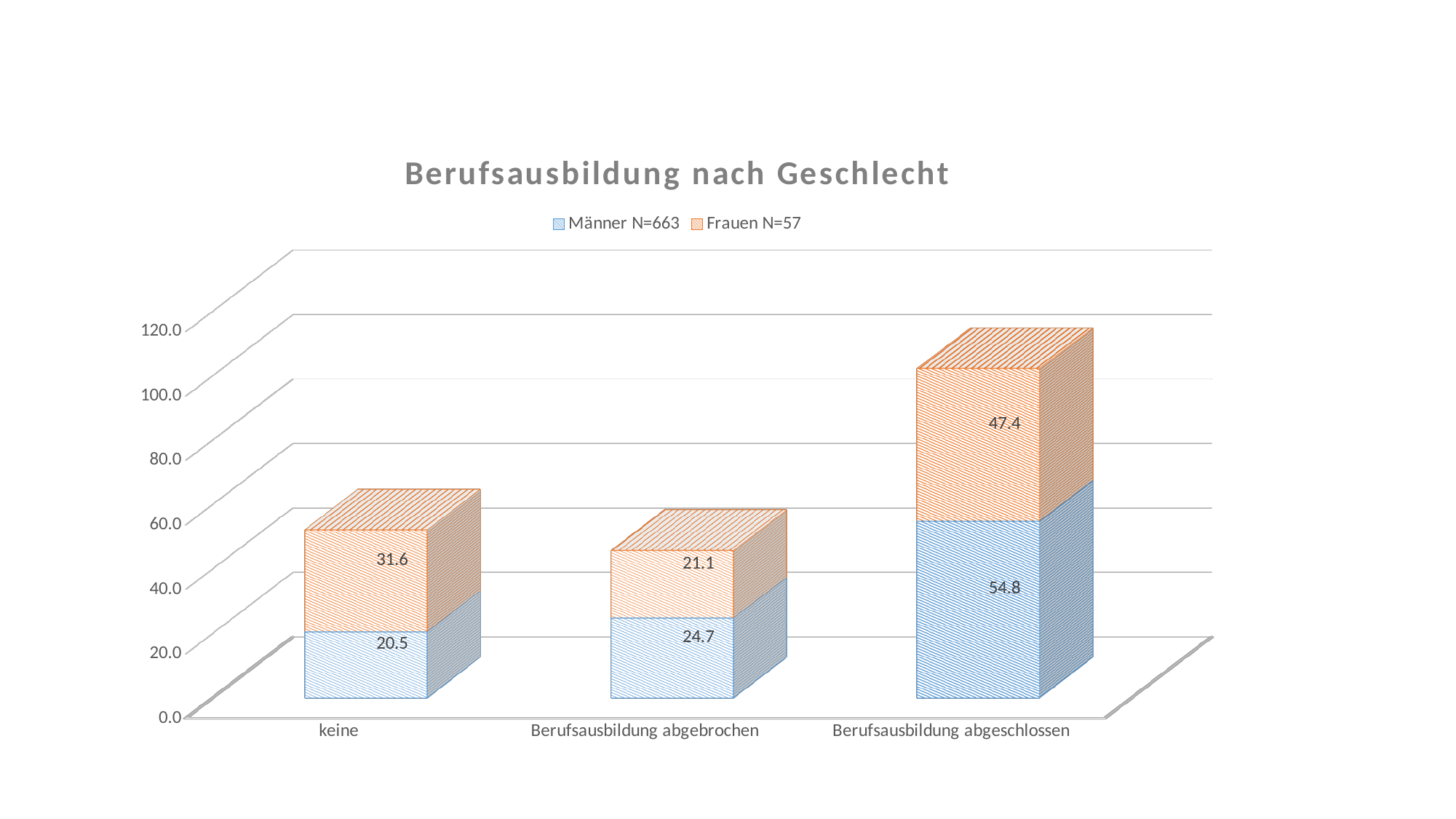
What is the value for Frauen N=57 in the 'Berufsausbildung abgebrochen' category? 21.1 How many categories are shown on the x axis? 3 What is the value for Frauen N=57 in the 'Berufsausbildung abgeschlossen' category? 47.4 What is the total of the stacked bar for 'keine'? 52.1 How many series does the legend list? 2 What is the title of the chart? Berufsausbildung nach Geschlecht What is the total of the stacked bar for 'Berufsausbildung abgeschlossen'? 102.2 What is the value for Männer N=663 in the 'keine' category? 20.5 Which is larger in the 'Berufsausbildung abgebrochen' category: the Männer N=663 value or the Frauen N=57 value? Männer N=663 Which category has the lowest value for Frauen N=57? Berufsausbildung abgebrochen Which category has the highest value for Männer N=663? Berufsausbildung abgeschlossen What is the difference between the Frauen N=57 value and the Männer N=663 value in the 'keine' category? 11.1